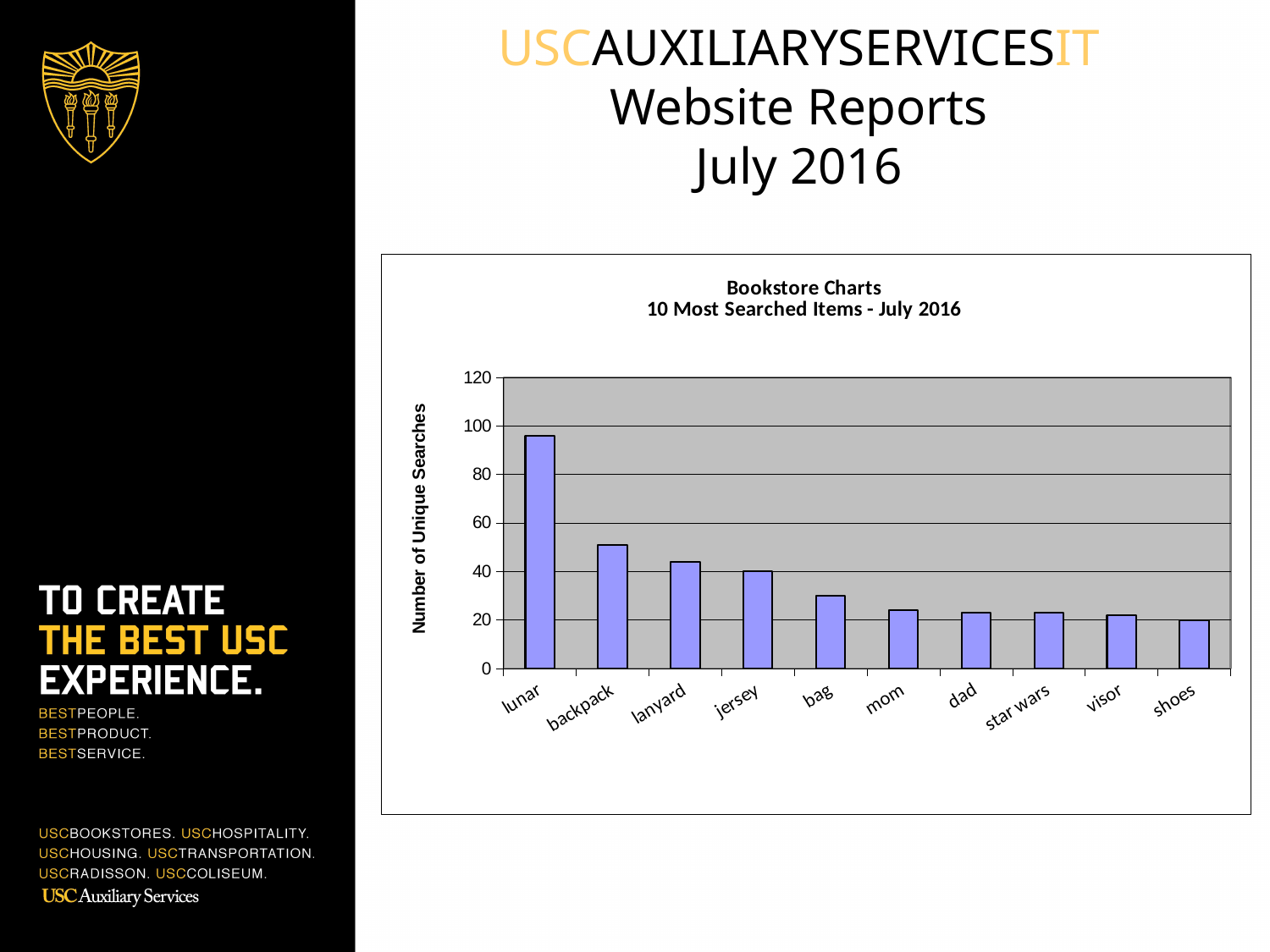
Is the value for bag greater or less than 40? less Is the value for backpack greater or less than 40? greater How many search items are shown on the x axis of the chart? 10 Do the values rise or fall moving from left to right along the x axis? fall Which search item has the highest number of unique searches? lunar What kind of chart is shown on the slide? bar chart Is the value for lunar greater or less than 100? less What is the label on the y axis of the chart? Number of Unique Searches Which has more unique searches, lanyard or bag? lanyard Which has more unique searches, lunar or backpack? lunar